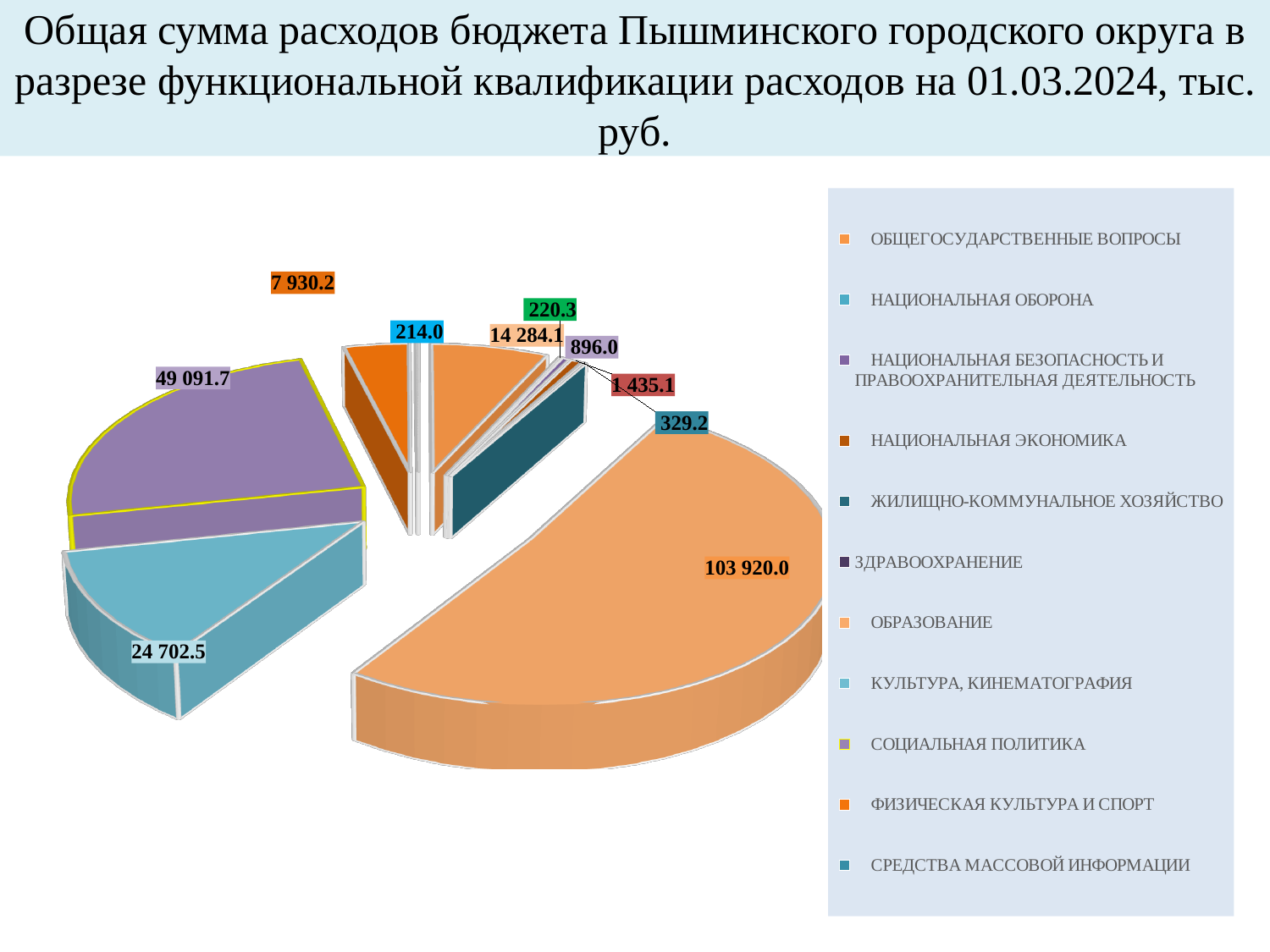
What kind of chart is shown on the slide? pie chart What value is shown for СОЦИАЛЬНАЯ ПОЛИТИКА? 49 091.7 What value is shown for КУЛЬТУРА, КИНЕМАТОГРАФИЯ? 24 702.5 Which category does the legend list first? ОБЩЕГОСУДАРСТВЕННЫЕ ВОПРОСЫ As of what date does the chart title say the budget expenditures are shown? 01.03.2024 What is the difference between the value for ОБРАЗОВАНИЕ (103 920.0) and the value for СОЦИАЛЬНАЯ ПОЛИТИКА (49 091.7)? 54 828.3 How many categories does the legend list? 11 What is the difference between the value for СОЦИАЛЬНАЯ ПОЛИТИКА (49 091.7) and the value for КУЛЬТУРА, КИНЕМАТОГРАФИЯ (24 702.5)? 24 389.2 What is the largest value labelled on the pie chart? 103 920.0 Which is larger: the value for СОЦИАЛЬНАЯ ПОЛИТИКА or the value for КУЛЬТУРА, КИНЕМАТОГРАФИЯ? СОЦИАЛЬНАЯ ПОЛИТИКА What value is shown for ОБРАЗОВАНИЕ? 103 920.0 What is the smallest value labelled on the pie chart? 214.0